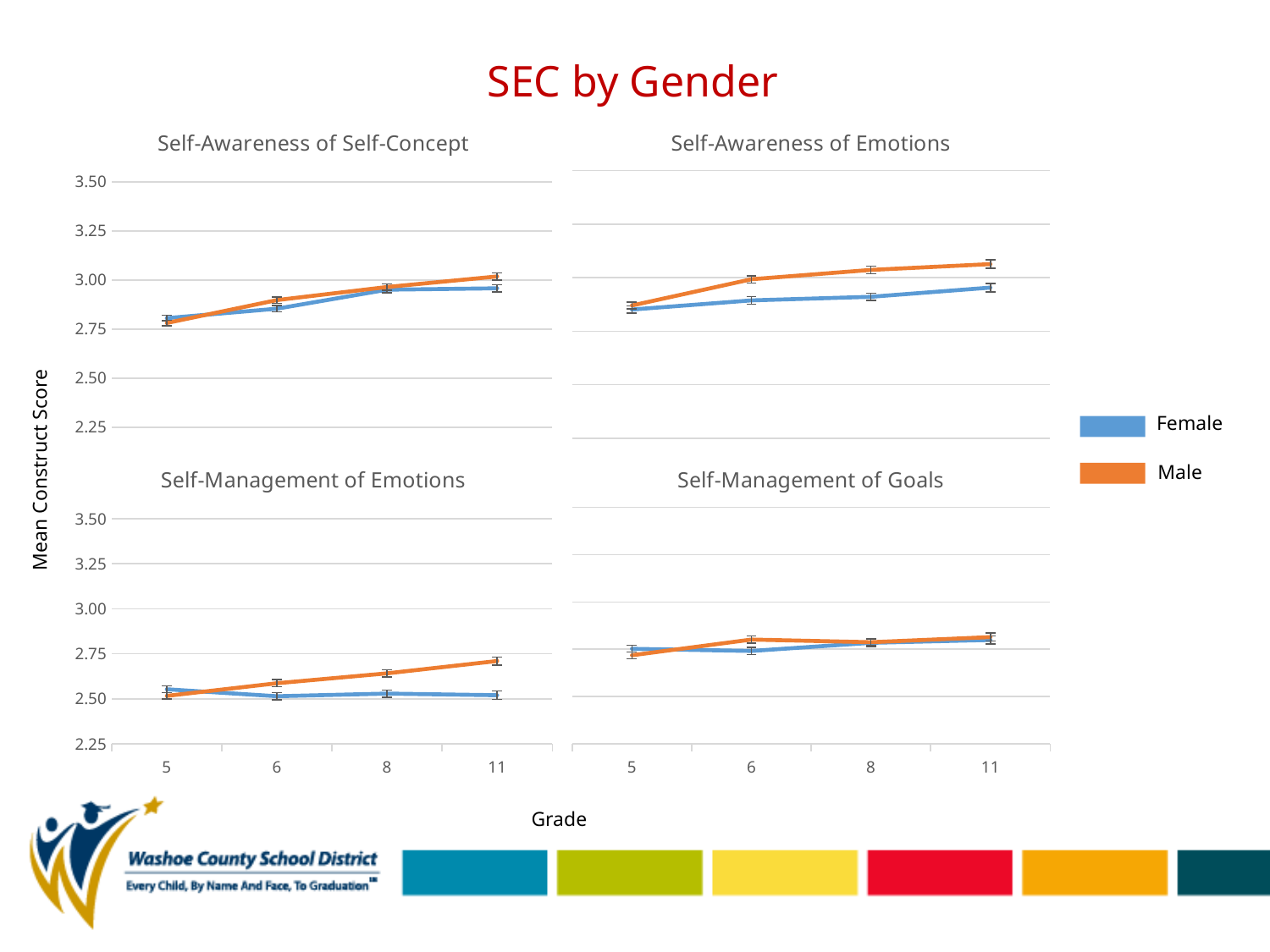
In the 'Self-Awareness of Self-Concept' chart, is the Female value at grade 5 greater or less than 3.00? less In the 'Self-Awareness of Emotions' chart, which series has the higher value at grade 8, Female or Male? Male In the 'Self-Management of Goals' chart, how many grade levels are plotted along the x axis? 4 In the 'Self-Management of Goals' chart, is the Male value at grade 5 greater or less than 3.00? less In the 'Self-Awareness of Self-Concept' chart, does the Male line rise or fall from grade 5 to grade 11? rise What is the label on the shared y axis of the charts? Mean Construct Score In the 'Self-Management of Emotions' chart, which series has the higher value at grade 11, Female or Male? Male How many series does the legend list for the charts on this slide? 2 In the 'Self-Management of Emotions' chart, is the Female value at grade 11 greater or less than 2.75? less What kind of chart is the 'Self-Awareness of Self-Concept' chart? line chart In the 'Self-Awareness of Emotions' chart, does the Male line rise or fall from grade 5 to grade 11? rise